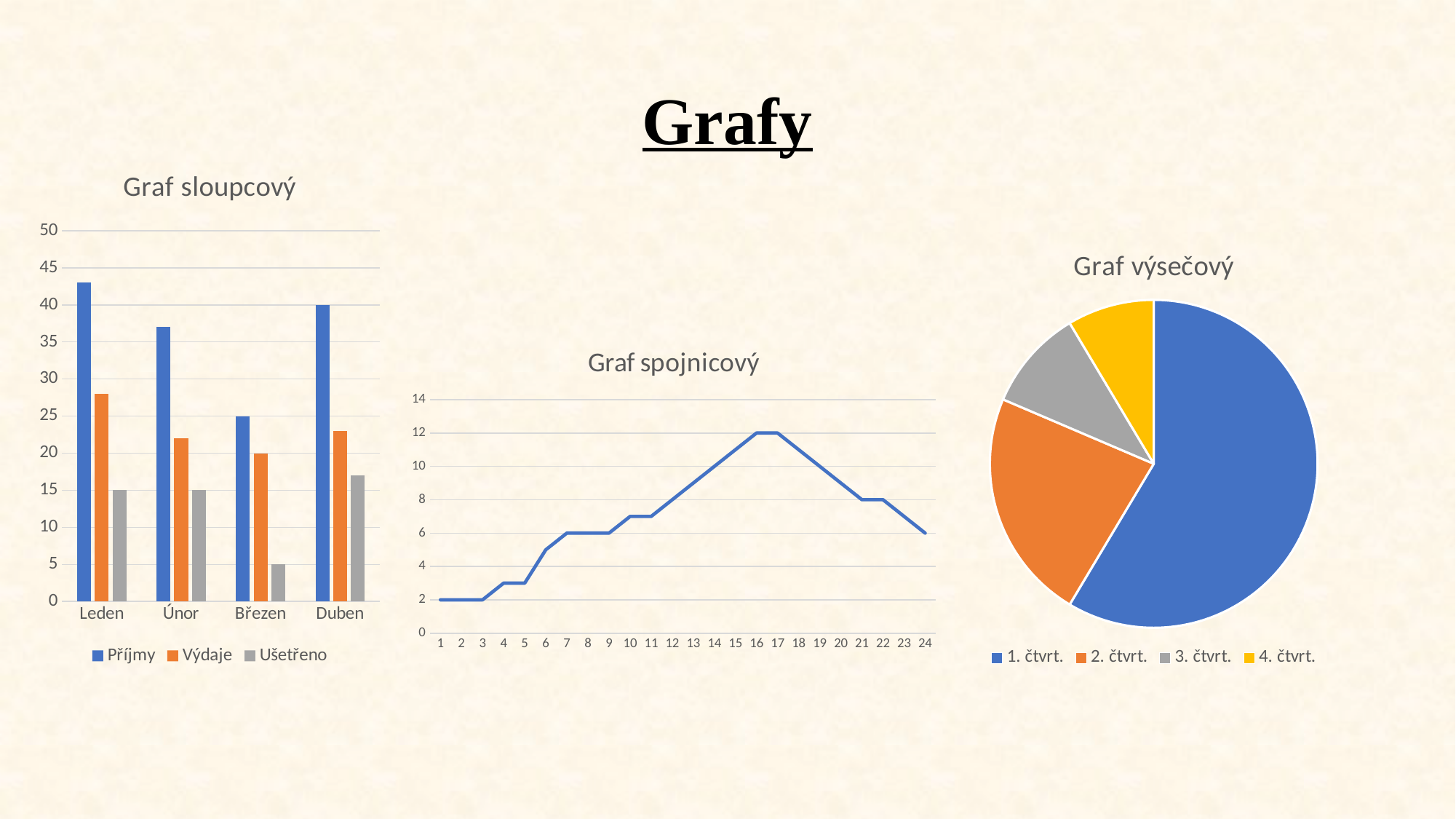
In "Graf sloupcový", is the value of Příjmy for Leden greater or less than 40? greater In "Graf spojnicový", what is the value at point 24? 6 In "Graf sloupcový", what is the value of Příjmy for Duben? 40 In "Graf spojnicový", what is the highest value reached by the line? 12 In "Graf sloupcový", what is the value of Ušetřeno for Březen? 5 In "Graf sloupcový", which is larger: Výdaje for Leden or Výdaje for Únor? Leden In "Graf sloupcový", how many series does the legend list? 3 In "Graf výsečový", which slice is the largest? 1. čtvrt. In "Graf spojnicový", how many points are on the x axis? 24 In "Graf sloupcový", which month has the highest Příjmy? Leden What kind of chart is "Graf sloupcový"? bar chart In "Graf sloupcový", how many categories are shown on the x axis? 4